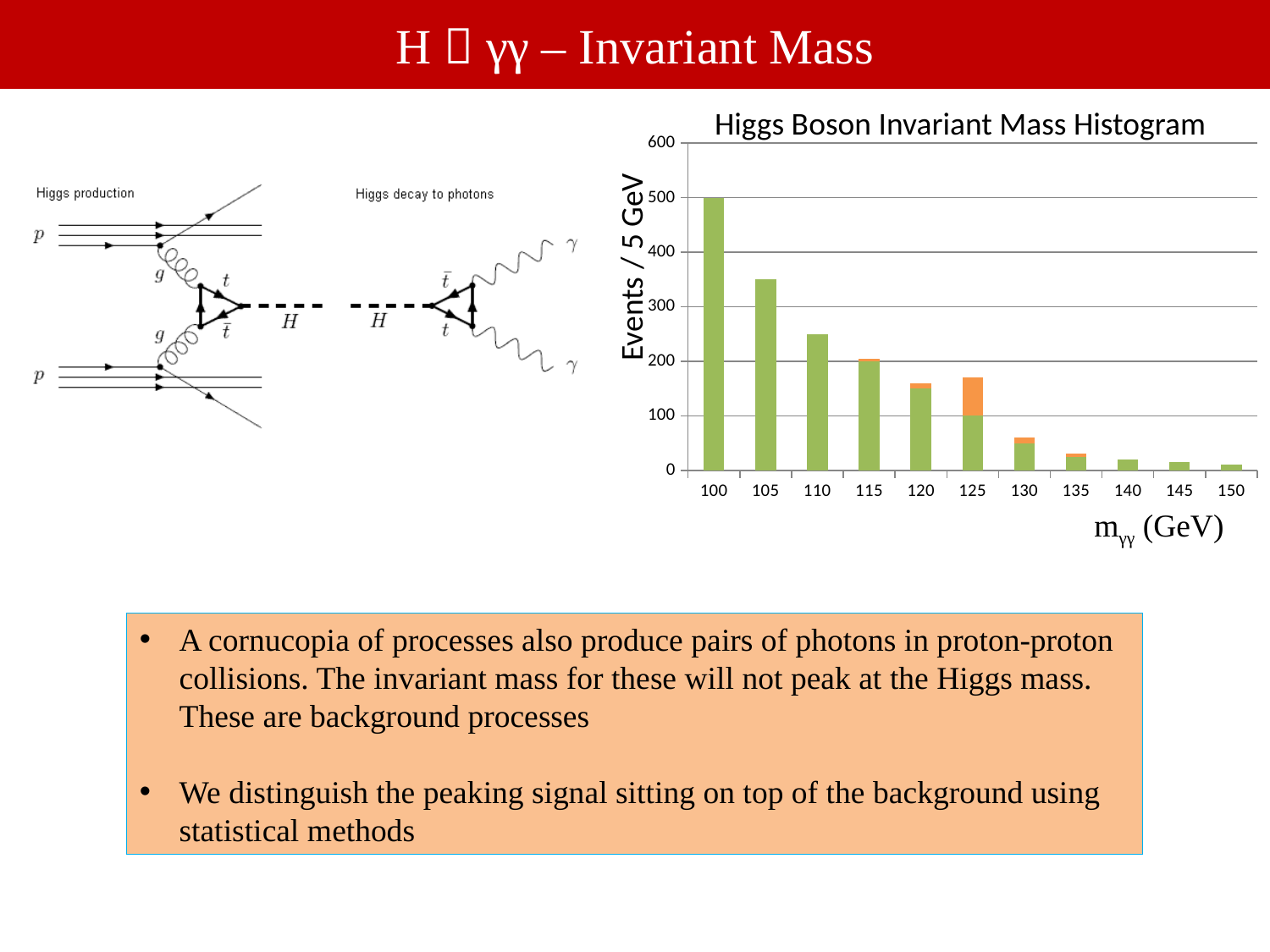
What kind of chart is shown on the slide? bar chart What is the label on the vertical axis of the chart? Events / 5 GeV What is the title of the chart? Higgs Boson Invariant Mass Histogram What is the number of events in the 100 GeV bin? 500 Do the bar heights generally rise or fall as the mass increases from 100 to 150 GeV? fall Is the value for the 105 GeV bin greater or less than 300? greater Which mass bin has the lowest total number of events? 150 Is the total value for the 125 GeV bin greater or less than 200? less Is the value for the 110 GeV bin greater or less than 300? less How many mass bins (categories) are shown along the x axis? 11 Which bin has more events, 105 GeV or 110 GeV? 105 Which mass bin has the highest total number of events? 100